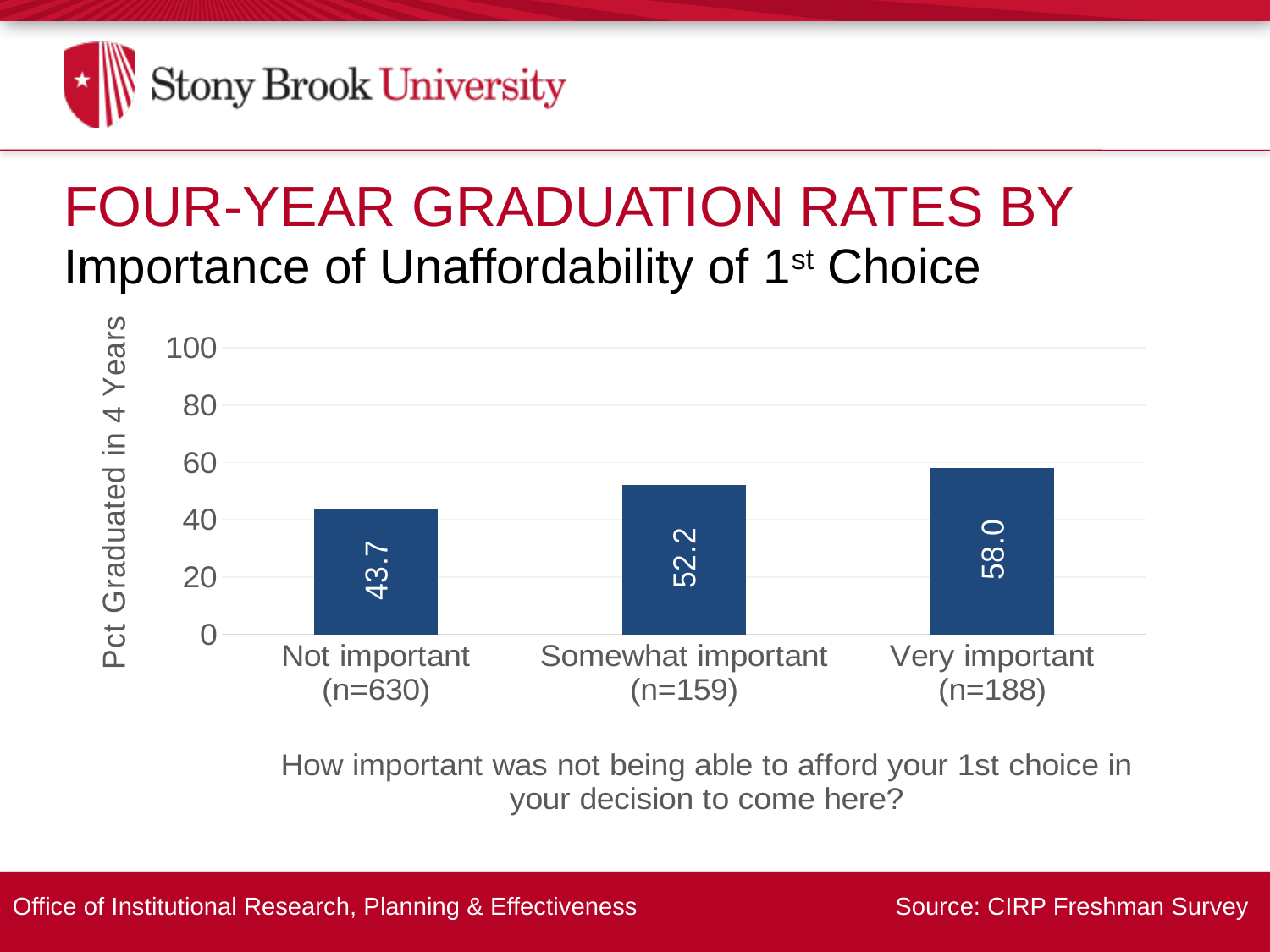
How many categories are shown on the x axis of the chart? 3 What is the difference in four-year graduation rate between the 'Somewhat important' and 'Not important' groups? 8.5 Is the four-year graduation rate for the 'Not important' group greater or less than 60? less What is the four-year graduation rate for the 'Somewhat important' group? 52.2 Which category has the highest four-year graduation rate? Very important What is the difference in four-year graduation rate between the 'Very important' and 'Not important' groups? 14.3 Do the four-year graduation rates rise or fall moving from 'Not important' to 'Very important'? Rise What is the four-year graduation rate for the 'Very important' group? 58.0 Which group has a higher four-year graduation rate, 'Somewhat important' or 'Very important'? Very important What kind of chart is shown on the slide? Bar chart Which category has the lowest four-year graduation rate? Not important What is the four-year graduation rate for students who said unaffordability of their 1st choice was 'Not important'? 43.7